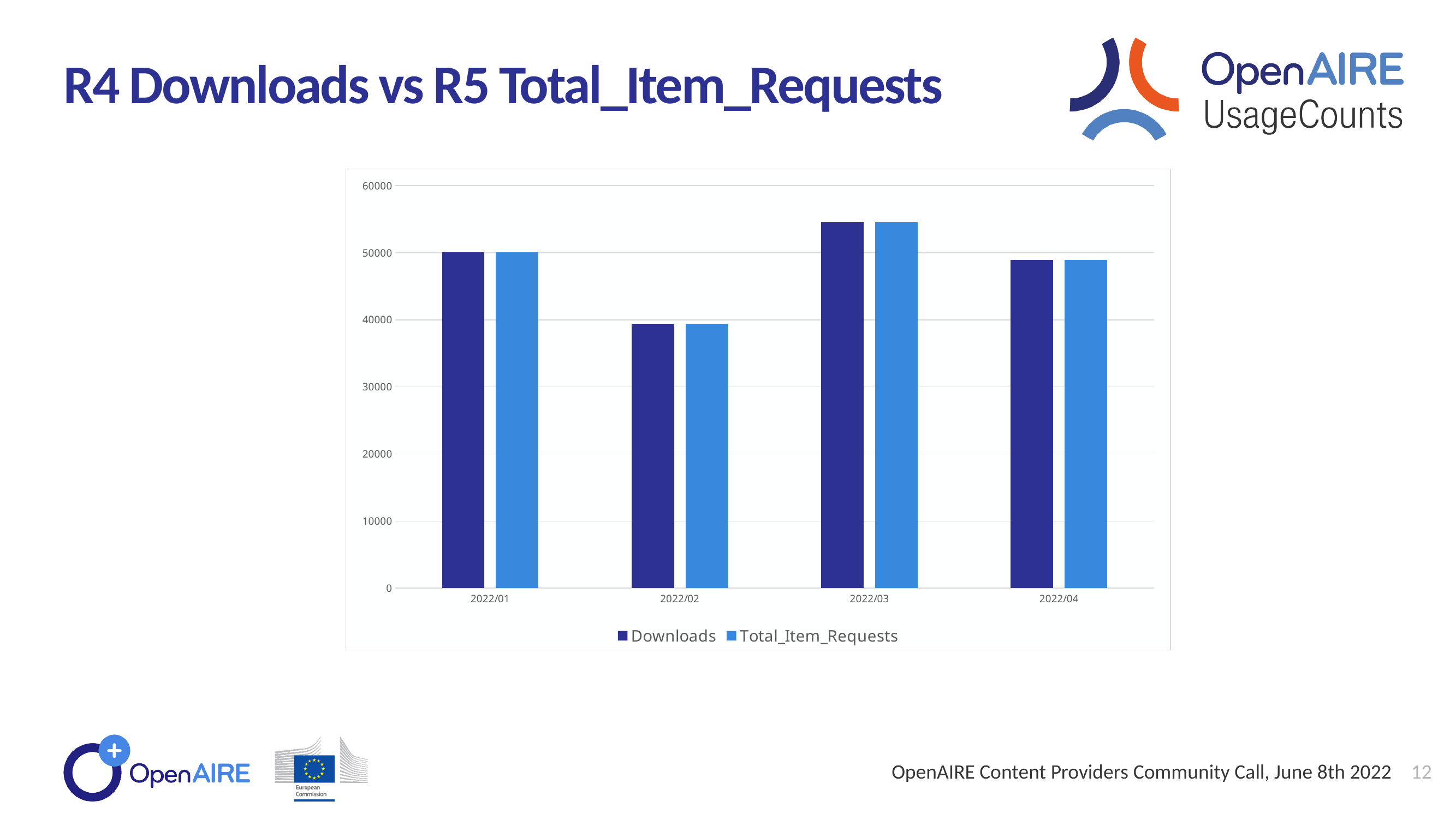
Is the Downloads value for 2022/01 greater or less than 40000? greater How many series does the legend list? 2 Do the Downloads values rise or fall from 2022/01 to 2022/02? fall What are the two series named in the legend? Downloads and Total_Item_Requests Which month has the lowest Total_Item_Requests value? 2022/02 Which month has the highest Downloads value? 2022/03 Is the Total_Item_Requests value for 2022/02 greater or less than 30000? greater What kind of chart is shown on the slide? bar chart Which is larger, Downloads for 2022/01 or Downloads for 2022/02? 2022/01 Is the Downloads value for 2022/03 greater or less than 50000? greater Which is larger, Total_Item_Requests for 2022/03 or Total_Item_Requests for 2022/04? 2022/03 How many months are shown on the x axis? 4